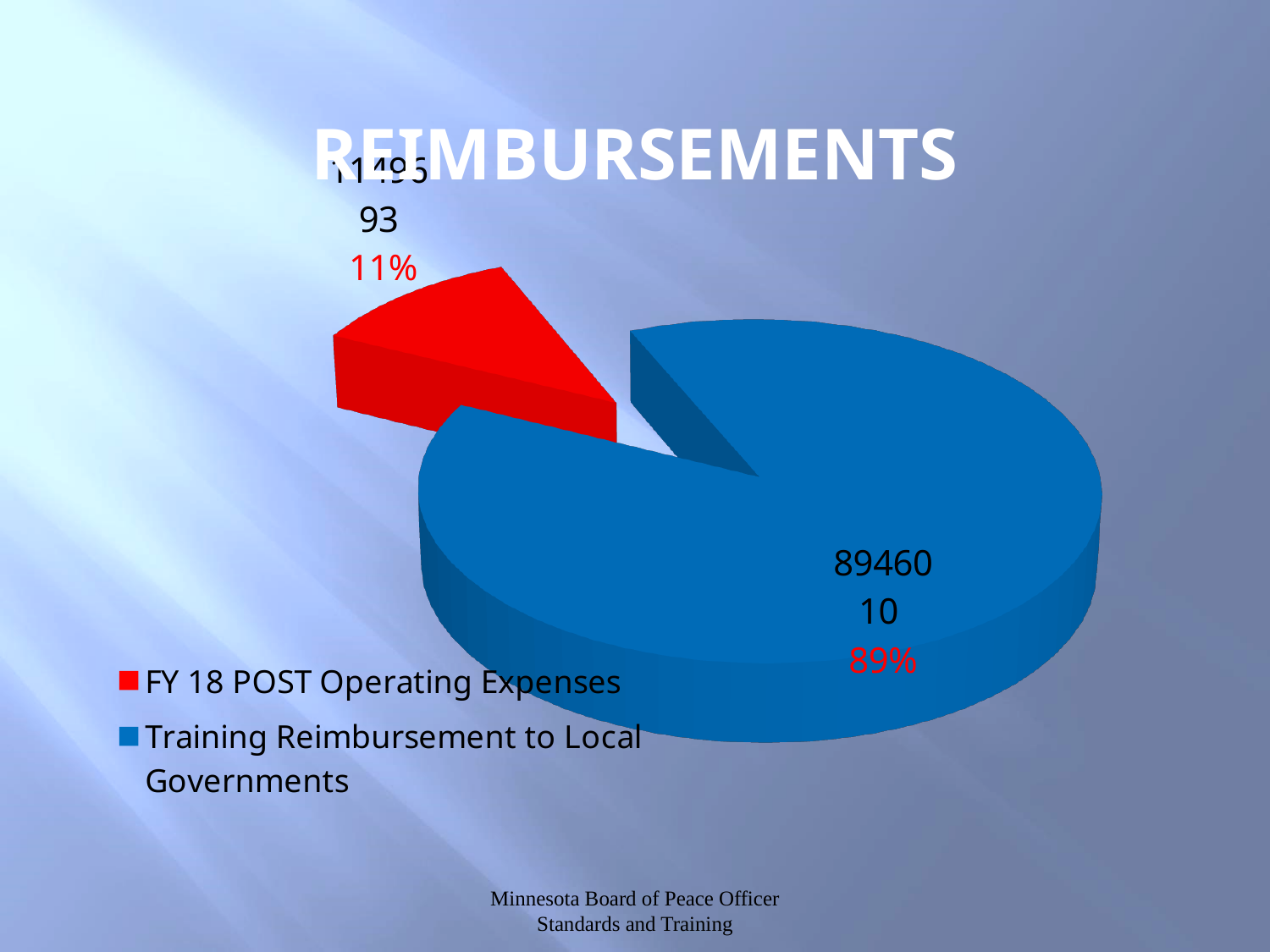
What kind of chart is shown on the slide? pie chart What share of the pie is Training Reimbursement to Local Governments? 89% How many entries does the legend list? 2 Which slice is the smallest in the pie chart? FY 18 POST Operating Expenses What is the title of the chart? REIMBURSEMENTS How many slices does the pie chart have? 2 Which slice is the largest in the pie chart? Training Reimbursement to Local Governments What share of the pie is FY 18 POST Operating Expenses? 11% Which is larger, the share for FY 18 POST Operating Expenses or the share for Training Reimbursement to Local Governments? Training Reimbursement to Local Governments What colour is the slice for FY 18 POST Operating Expenses? red What is the difference in percentage points between the Training Reimbursement to Local Governments share and the FY 18 POST Operating Expenses share? 78